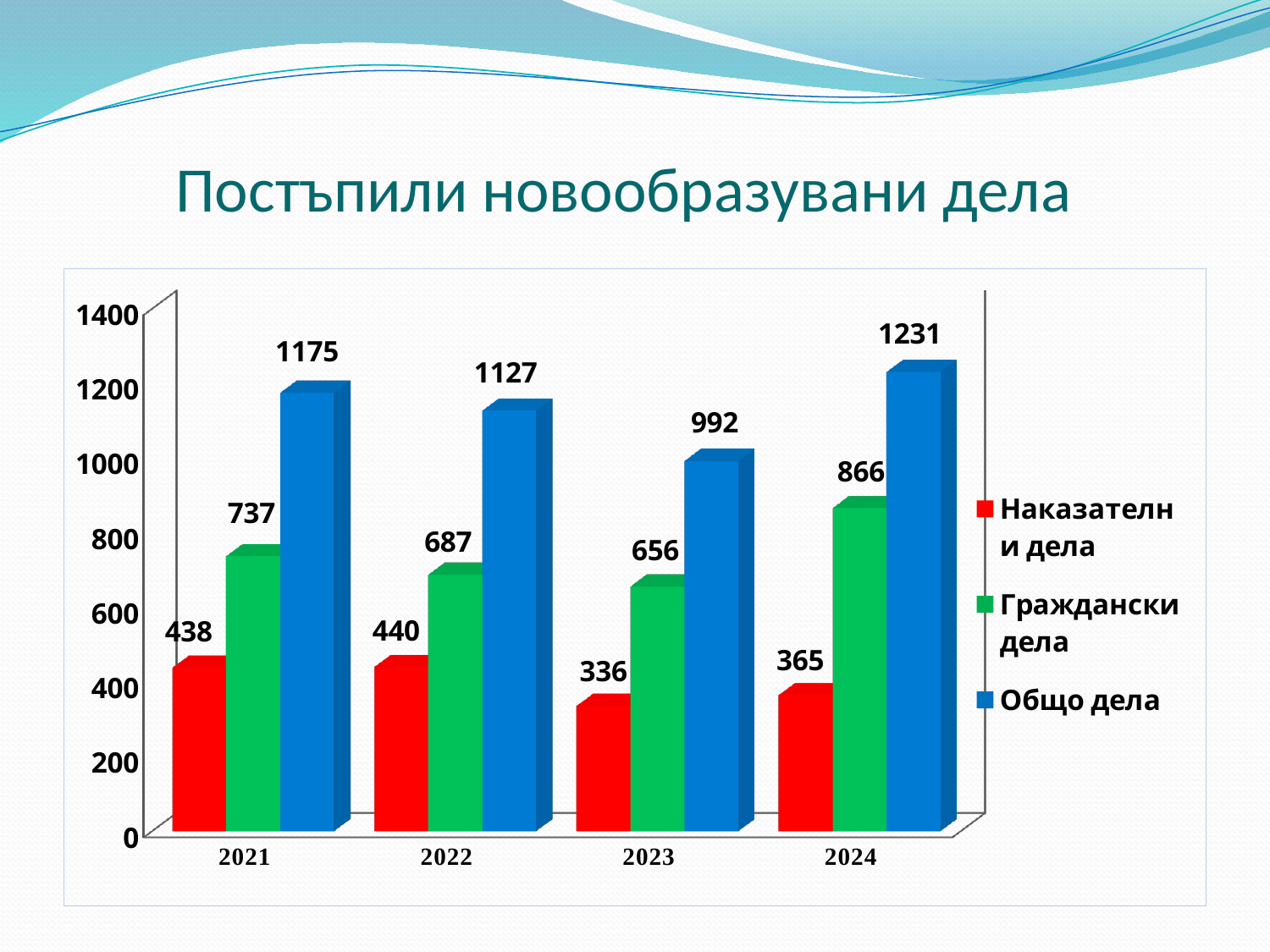
In which year is Наказателни дела lowest? 2023 What is the difference between Общо дела in 2024 and in 2023? 239 Which is larger: Граждански дела in 2021 or Граждански дела in 2022? 2021 What is the value for Наказателни дела in 2021? 438 What is the title of the chart? Постъпили новообразувани дела What is the value for Граждански дела in 2024? 866 How many years are shown on the x axis? 4 What is the value for Общо дела in 2023? 992 Is the value for Общо дела in 2022 greater or less than 1000? greater In which year is Общо дела highest? 2024 What kind of chart is shown on the slide? bar chart How many series does the legend list? 3